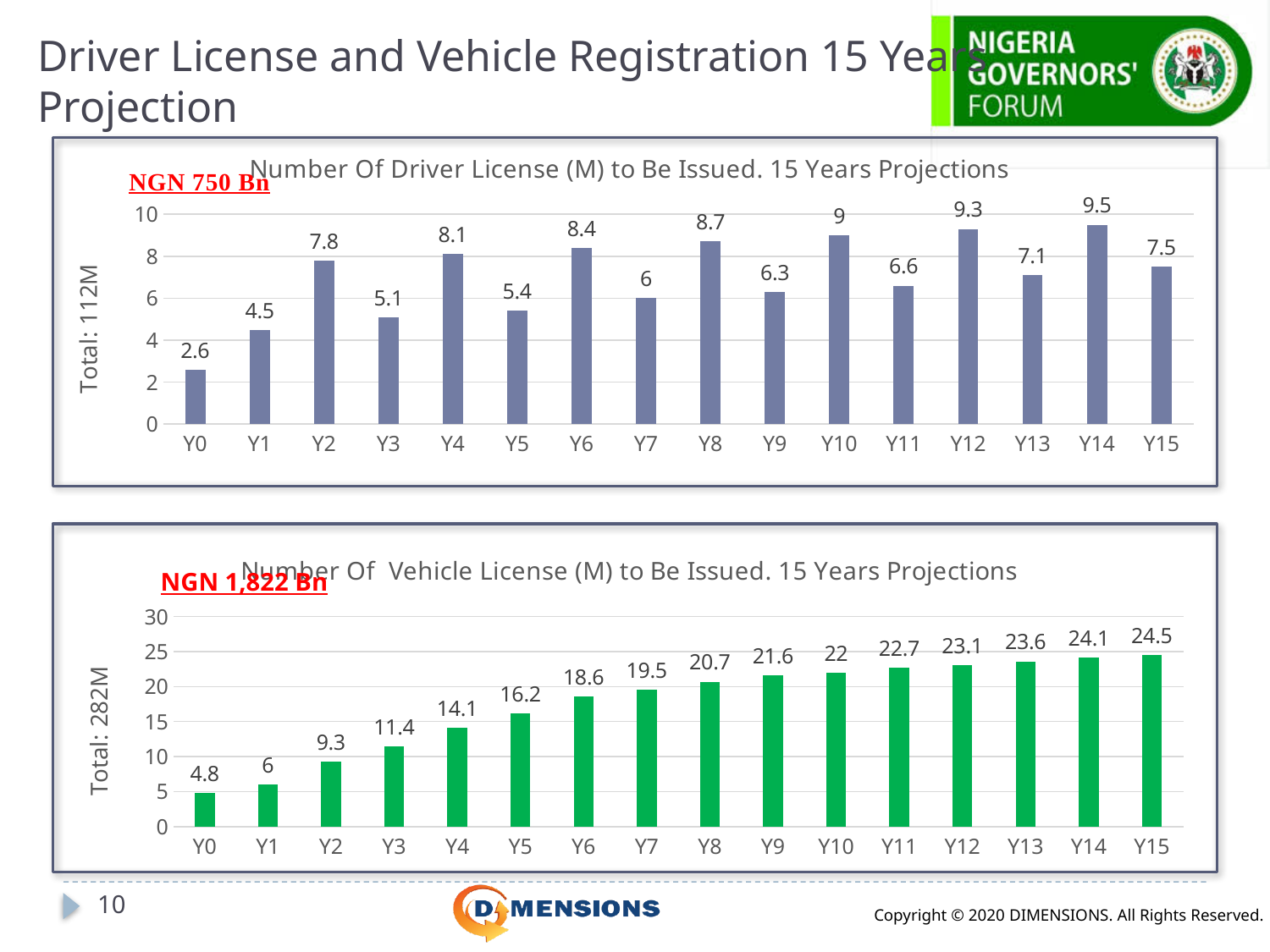
In the 'Number Of Vehicle License (M) to Be Issued' chart, which year has the highest value? Y15 In the 'Number Of Vehicle License (M) to Be Issued' chart, what is the difference between the values for Y15 and Y0? 19.7 In the 'Number Of Driver License (M) to Be Issued' chart, which year has the highest value? Y14 What is the y-axis label of the 'Number Of Vehicle License (M) to Be Issued' chart? Total: 282M In the 'Number Of Driver License (M) to Be Issued' chart, which year has the lowest value? Y0 In the 'Number Of Vehicle License (M) to Be Issued' chart, do the values rise or fall from Y0 to Y15? rise In the 'Number Of Driver License (M) to Be Issued' chart, what is the value for Y2? 7.8 In the 'Number Of Driver License (M) to Be Issued' chart, what is the difference between the values for Y14 and Y15? 2 In the 'Number Of Vehicle License (M) to Be Issued' chart, what is the value for Y5? 16.2 In the 'Number Of Driver License (M) to Be Issued' chart, how many years are shown on the x axis? 16 In the 'Number Of Driver License (M) to Be Issued' chart, which is larger, the value for Y3 or the value for Y4? Y4 What kind of chart is the 'Number Of Vehicle License (M) to Be Issued' chart? bar chart